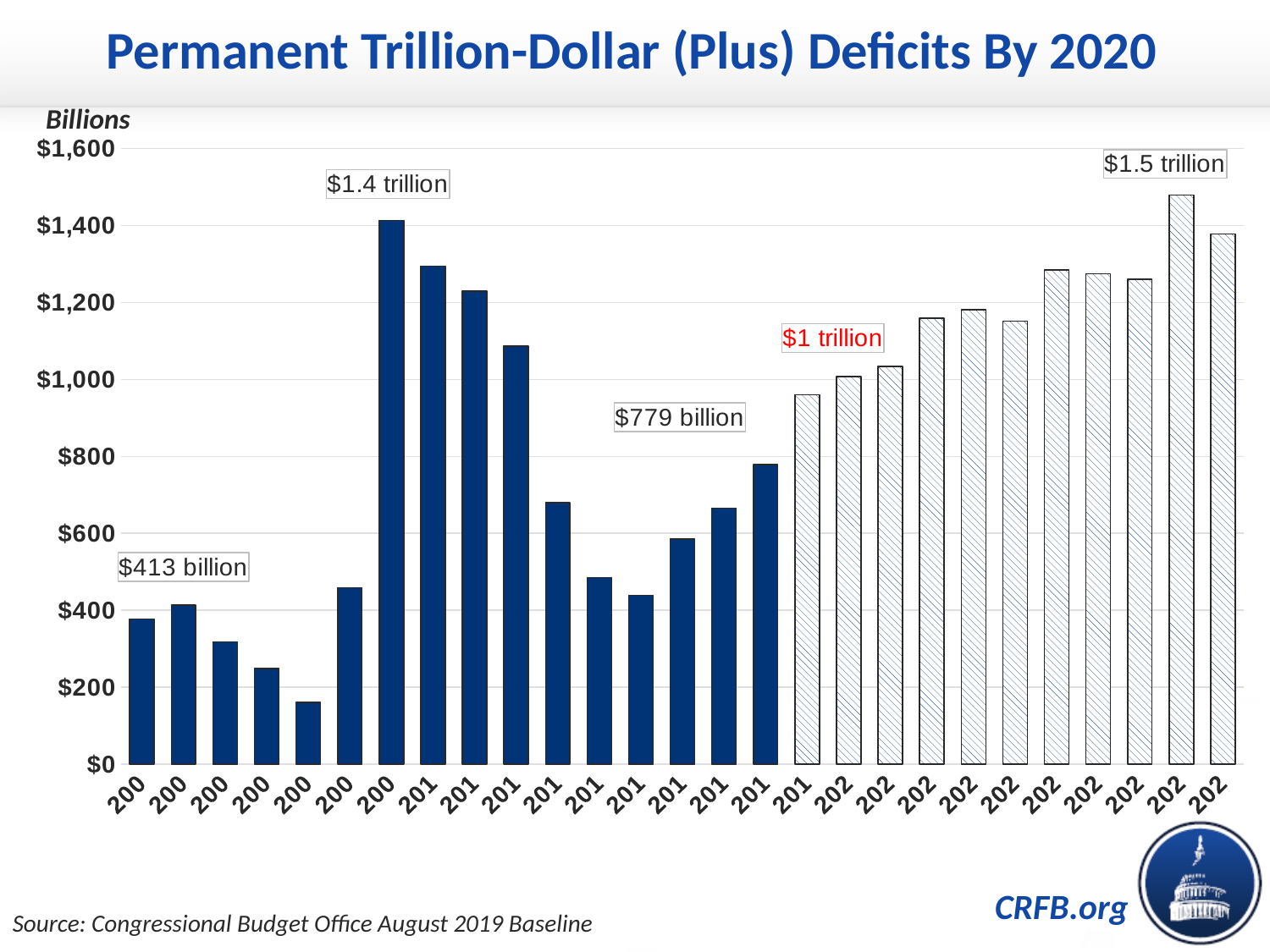
What value is labeled on the tallest solid blue bar? $1.4 trillion What kind of chart is shown on the slide? bar chart Is the value of the shortest bar on the chart greater or less than $200? less What value is labeled on the last solid blue bar before the hatched bars begin? $779 billion Which is taller: the tallest solid blue bar or the tallest hatched bar? the tallest hatched bar What value is labeled near the second bar from the left? $413 billion What value is labeled in red text above the first hatched bar? $1 trillion Is the value of the tallest hatched bar greater or less than $1,400? greater What value is labeled on the tallest hatched bar at the right of the chart? $1.5 trillion What is the title of the chart? Permanent Trillion-Dollar (Plus) Deficits By 2020 What unit is the vertical axis labeled in? Billions Do the hatched bars generally rise or fall from left to right? rise